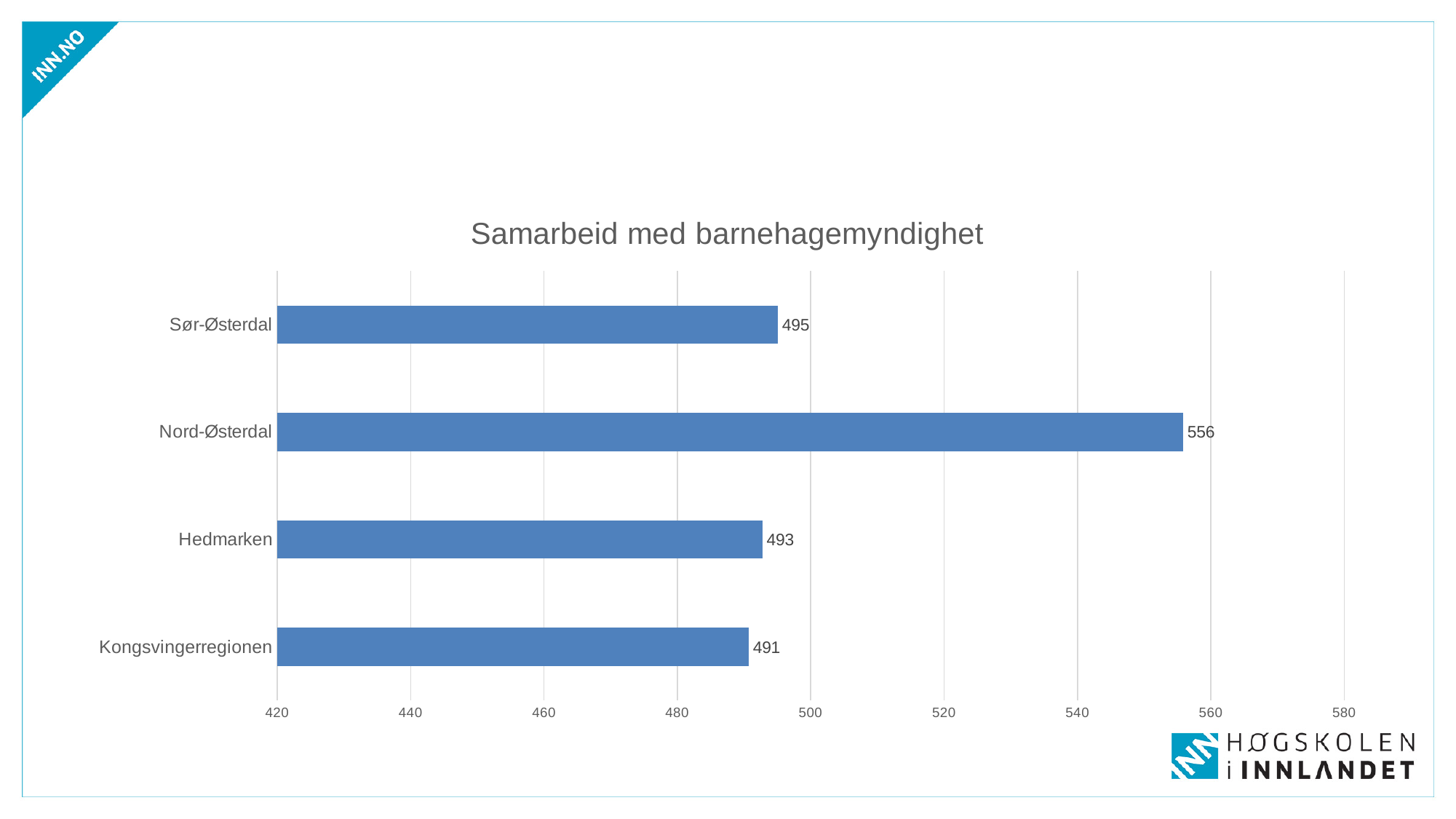
Is the value for Nord-Østerdal greater or less than 540? greater How many categories are shown in the chart? 4 What is the value for Hedmarken? 493 What kind of chart is shown on the slide? Bar chart What is the difference between the values for Nord-Østerdal and Kongsvingerregionen? 65 What is the value for Nord-Østerdal? 556 What is the value for Kongsvingerregionen? 491 Which category has the highest value? Nord-Østerdal Is the value for Kongsvingerregionen greater or less than 500? less What is the difference between the values for Sør-Østerdal and Hedmarken? 2 What is the title of the chart? Samarbeid med barnehagemyndighet What is the value for Sør-Østerdal? 495